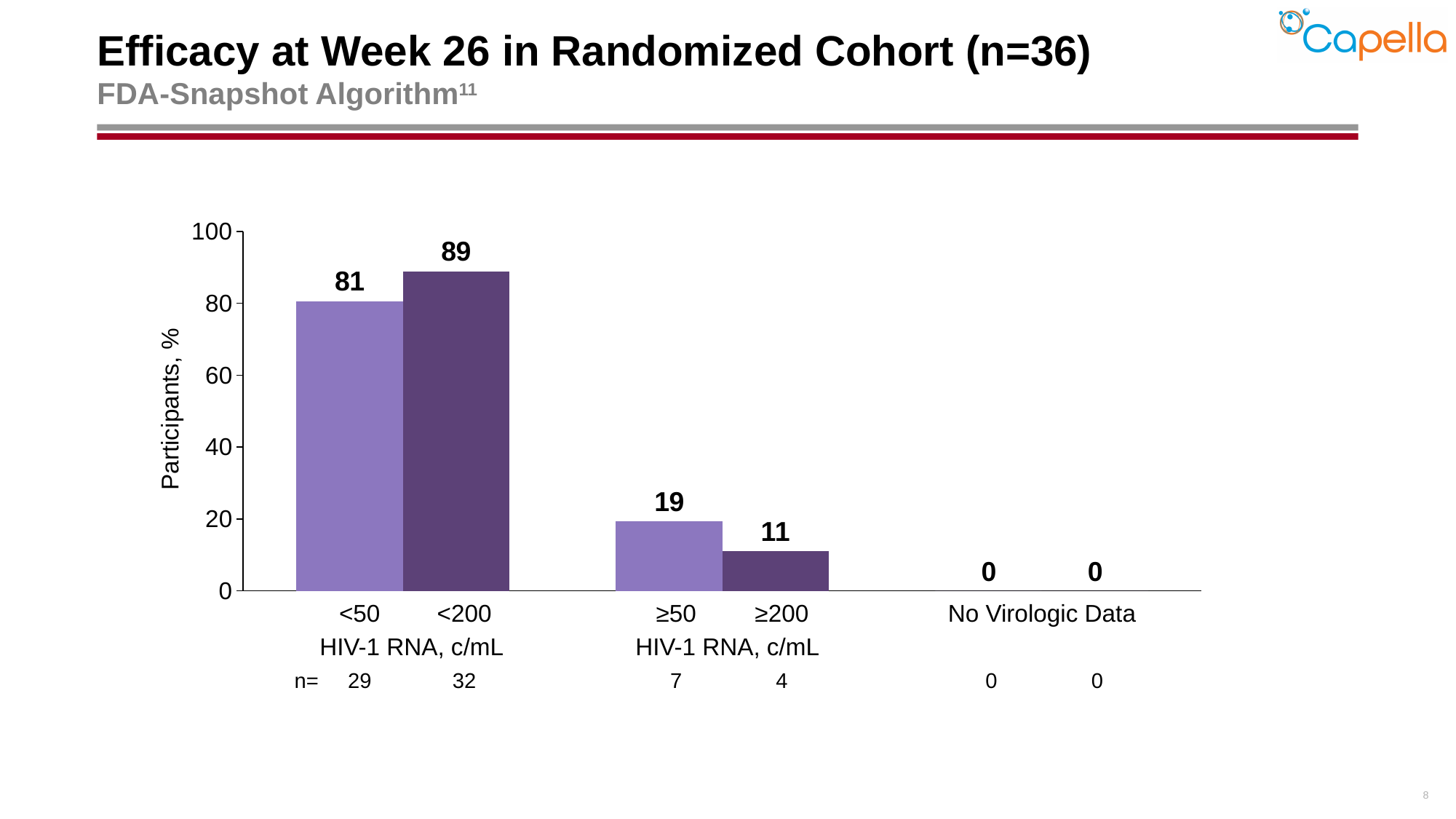
What percentage of participants had HIV-1 RNA <50 c/mL? 81 What is the difference between the percentages for ≥50 and ≥200? 8 What percentage of participants had HIV-1 RNA <200 c/mL? 89 What percentage of participants had HIV-1 RNA ≥50 c/mL? 19 What percentage of participants had HIV-1 RNA ≥200 c/mL? 11 Which category has the highest percentage of participants? <200 What is the difference between the percentages for <200 and <50? 8 Which is larger, the percentage for <50 or the percentage for ≥50? <50 What percentage of participants had No Virologic Data? 0 What type of chart is shown on the slide? Bar chart What is the label of the y axis? Participants, % What is the n value shown under the <200 bar? 32